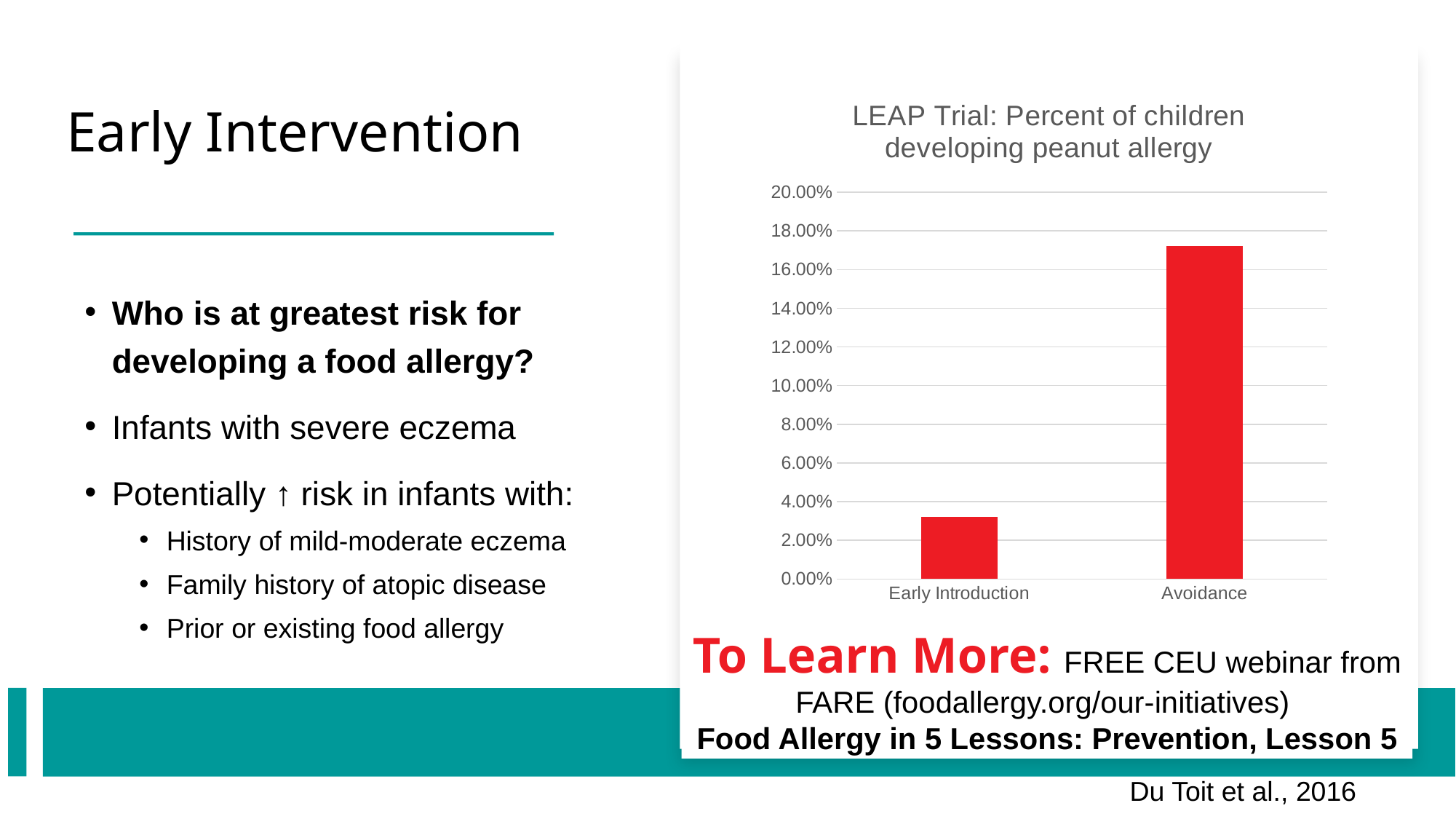
Is the value for Avoidance greater or less than 16.00%? greater Which category has the lowest percentage of children developing peanut allergy? Early Introduction Is the value for Early Introduction greater or less than 2.00%? greater Which category has the highest percentage of children developing peanut allergy? Avoidance What is the maximum value shown on the y axis of the chart? 20.00% What are the two category labels on the x axis of the chart? Early Introduction and Avoidance What is the title of the chart? LEAP Trial: Percent of children developing peanut allergy What type of chart is shown on the slide? bar chart Which is larger, the value for Early Introduction or the value for Avoidance? Avoidance How many categories are shown on the x axis of the chart? 2 Is the value for Early Introduction greater or less than 4.00%? less